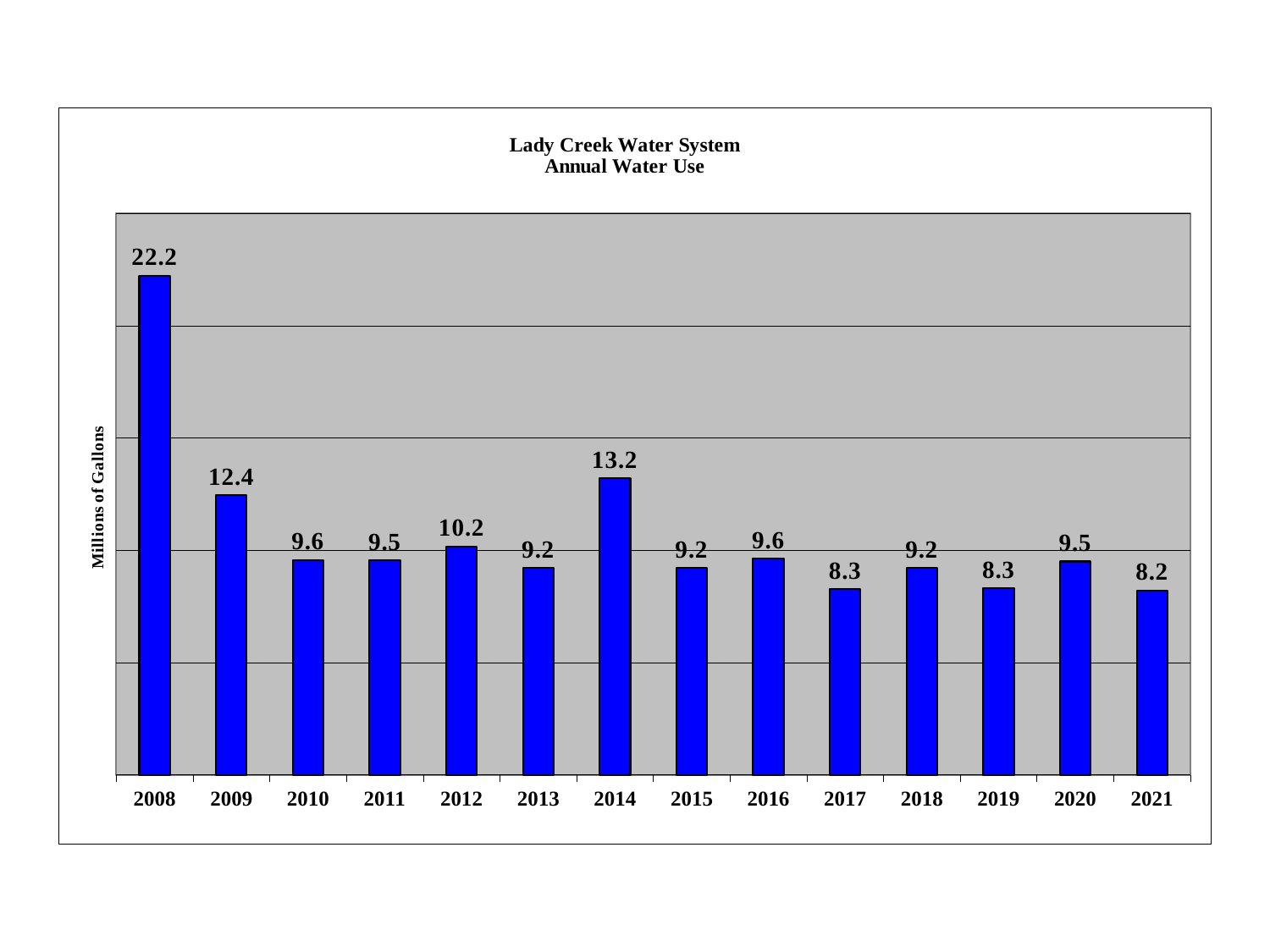
What is the label on the vertical axis? Millions of Gallons What is the title of the chart? Lady Creek Water System Annual Water Use What was the annual water use in 2008? 22.2 What was the annual water use in 2021? 8.2 What was the annual water use in 2014? 13.2 What is the difference in water use between 2008 and 2009? 9.8 How many years are shown on the chart? 14 What type of chart is shown on the slide? Bar chart What is the difference in water use between 2014 and 2013? 4.0 Which year had the highest annual water use? 2008 Which year had higher water use, 2012 or 2016? 2012 Which year had the lowest annual water use? 2021